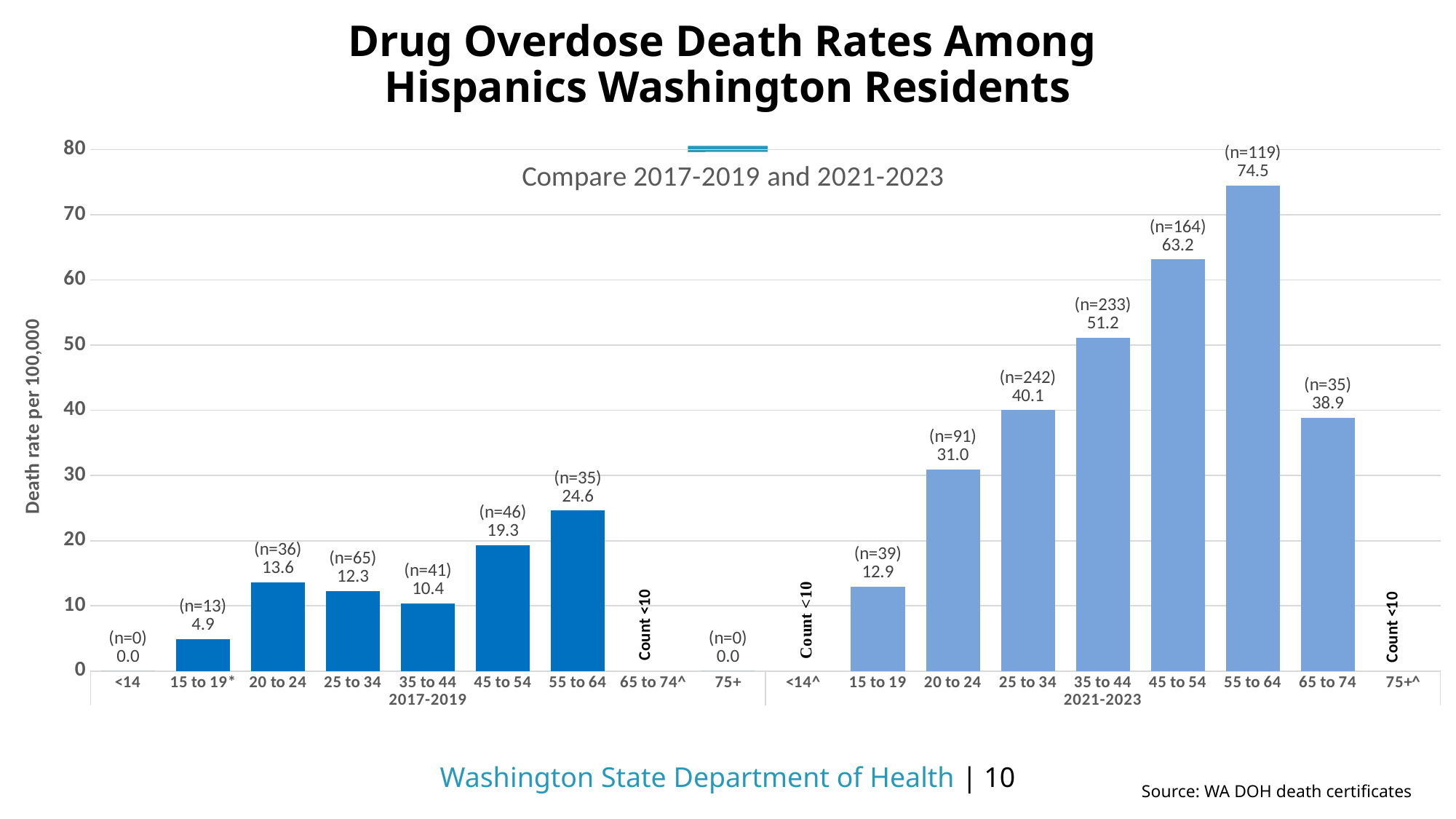
Which age group has the highest death rate in the 2017-2019 period? 55 to 64 What kind of chart is shown on the slide? Bar chart Do the death rates rise or fall from the 15 to 19 group to the 55 to 64 group in 2021-2023? Rise Which age group has the highest death rate in the 2021-2023 period? 55 to 64 What is the death rate per 100,000 for the 55 to 64 age group in 2021-2023? 74.5 Which is larger: the 45 to 54 death rate in 2017-2019 or the 15 to 19 death rate in 2021-2023? 45 to 54 in 2017-2019 What is the death rate per 100,000 for the 20 to 24 age group in 2017-2019? 13.6 What is the count (n) shown for the 35 to 44 age group in 2021-2023? n=233 Is the death rate for the 25 to 34 age group in 2021-2023 greater or less than 30? greater What is the difference between the 55 to 64 death rate in 2021-2023 and in 2017-2019? 49.9 What is the label on the vertical axis of the chart? Death rate per 100,000 How many age group categories are shown on the x axis for the 2017-2019 period? 9